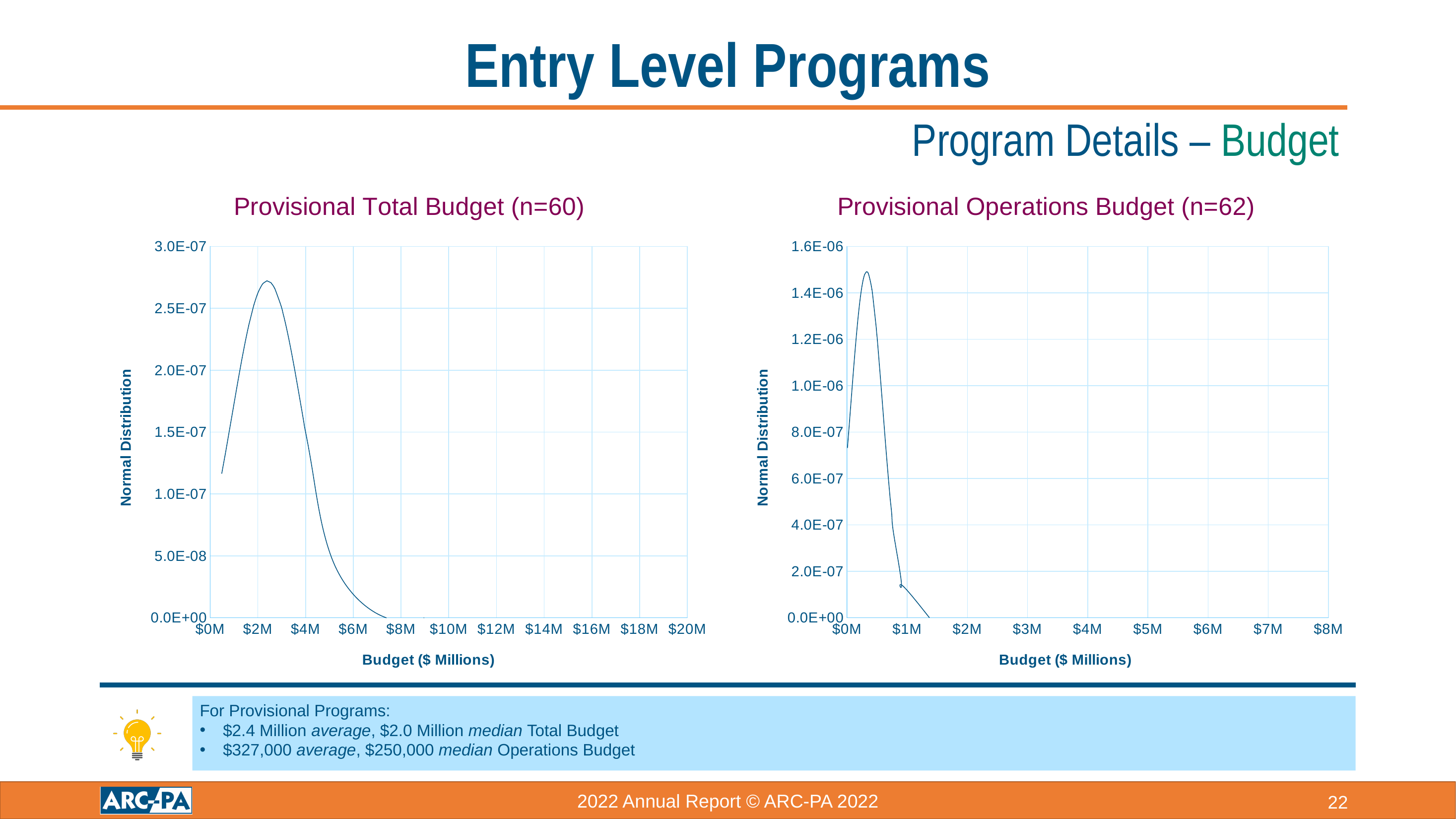
In the Provisional Total Budget (n=60) chart, is the value of the curve at $10M greater or less than 5.0E-08? less Which chart has the higher peak value on its y axis, Provisional Total Budget (n=60) or Provisional Operations Budget (n=62)? Provisional Operations Budget (n=62) In the Provisional Total Budget (n=60) chart, is the value of the curve at $2M greater or less than 2.0E-07? greater In the Provisional Total Budget (n=60) chart, is the peak value of the curve greater or less than 2.5E-07? greater What is the title of the chart on the right side of the slide? Provisional Operations Budget (n=62) What is the y-axis label on the Provisional Total Budget (n=60) chart? Normal Distribution In the Provisional Total Budget (n=60) chart, does the curve rise or fall between $4M and $8M? fall In the Provisional Operations Budget (n=62) chart, does the curve rise or fall between $1M and $2M? fall What kind of chart is the Provisional Total Budget (n=60) chart? Line chart